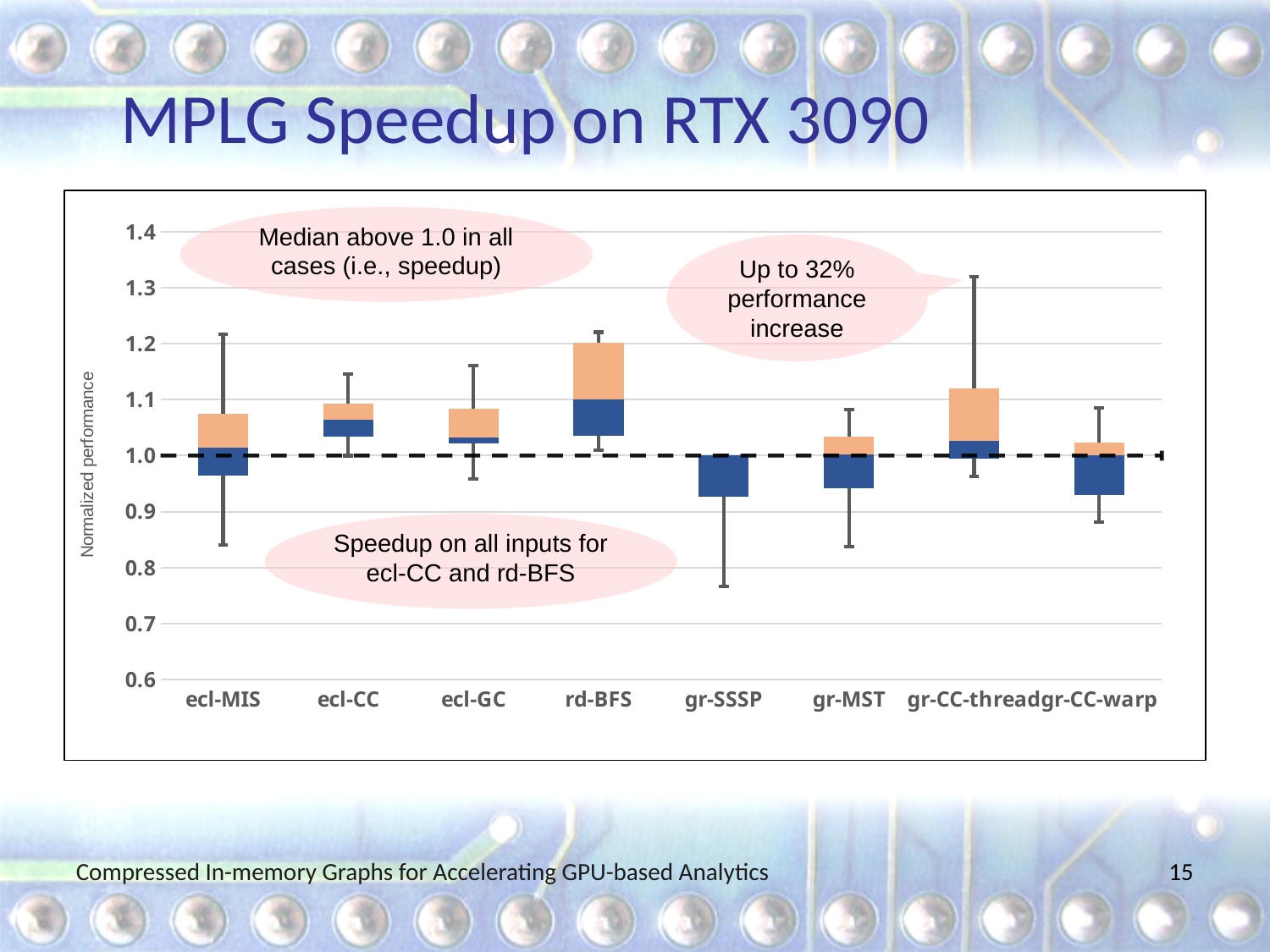
At what value is the horizontal dashed line drawn across the chart? 1.0 Is the upper whisker for ecl-CC greater or less than 1.1? greater What is the label of the y axis of the chart? Normalized performance Which category has the lowest lower whisker in the chart? gr-SSSP Which category has the highest upper whisker in the chart? gr-CC-thread What kind of chart is shown on the slide? Box-and-whisker plot Is the lower whisker for ecl-MIS greater or less than 0.9? less Is the upper whisker for ecl-GC greater or less than 1.1? greater Which category reaches a higher upper whisker, gr-CC-thread or rd-BFS? gr-CC-thread How many categories are shown along the x axis of the chart? 8